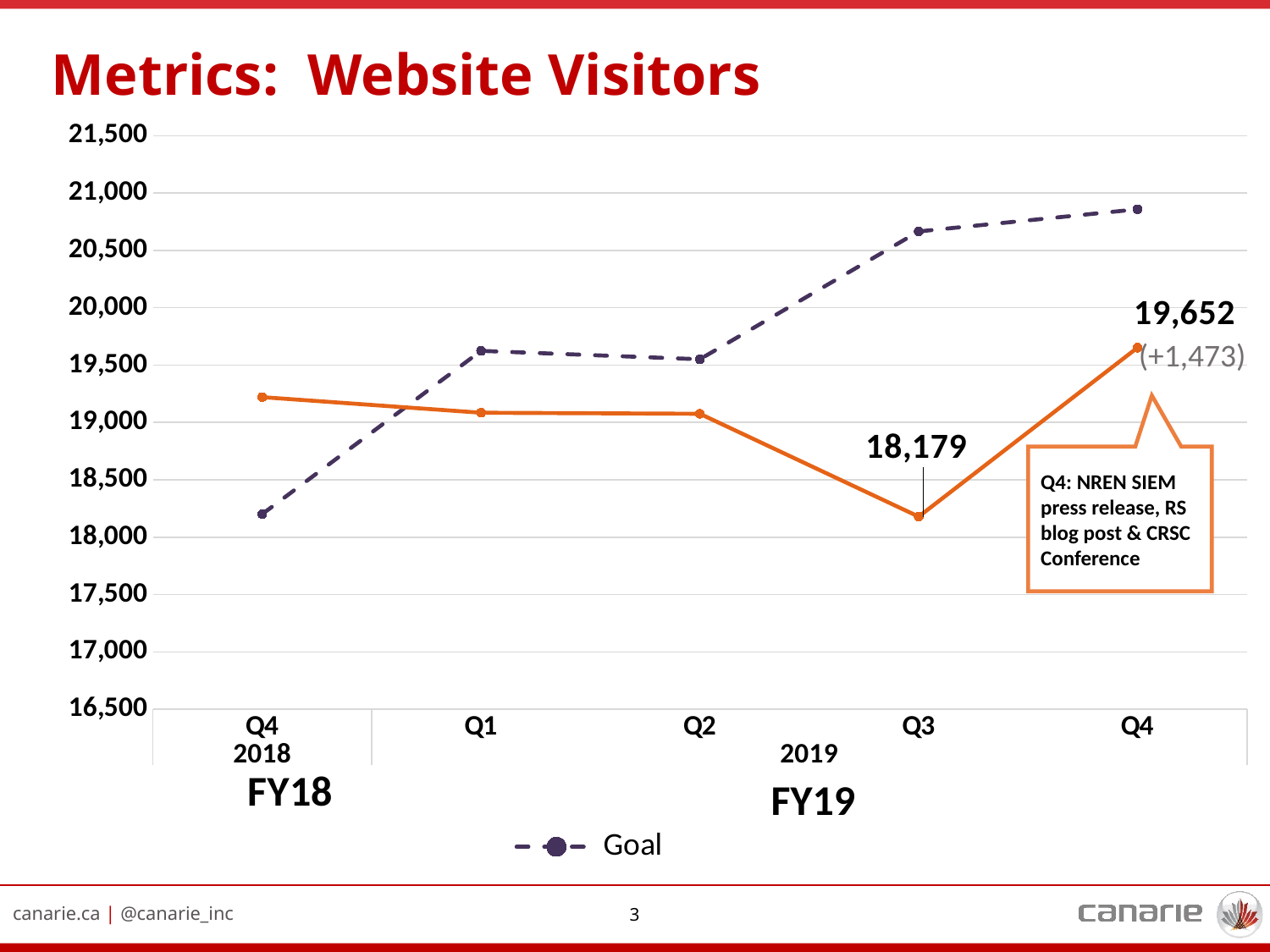
What is the value of the solid orange line at Q3 2019? 18,179 What is the value of the solid orange line at Q4 2019? 19,652 At Q4 2018, which is higher: the Goal line or the solid orange line? the solid orange line At which quarter is the solid orange line at its highest? Q4 2019 Is the Goal value at Q4 2018 greater or less than 18,500? less By how much did the solid orange line increase from Q3 2019 to Q4 2019? 1,473 At which quarter is the solid orange line at its lowest? Q3 2019 Is the Goal value at Q4 2019 greater or less than 20,500? greater How many series does the legend list? 1 What kind of chart is shown on the slide? line chart What is the title of the chart on the slide? Metrics: Website Visitors How many quarters are plotted along the x axis? 5